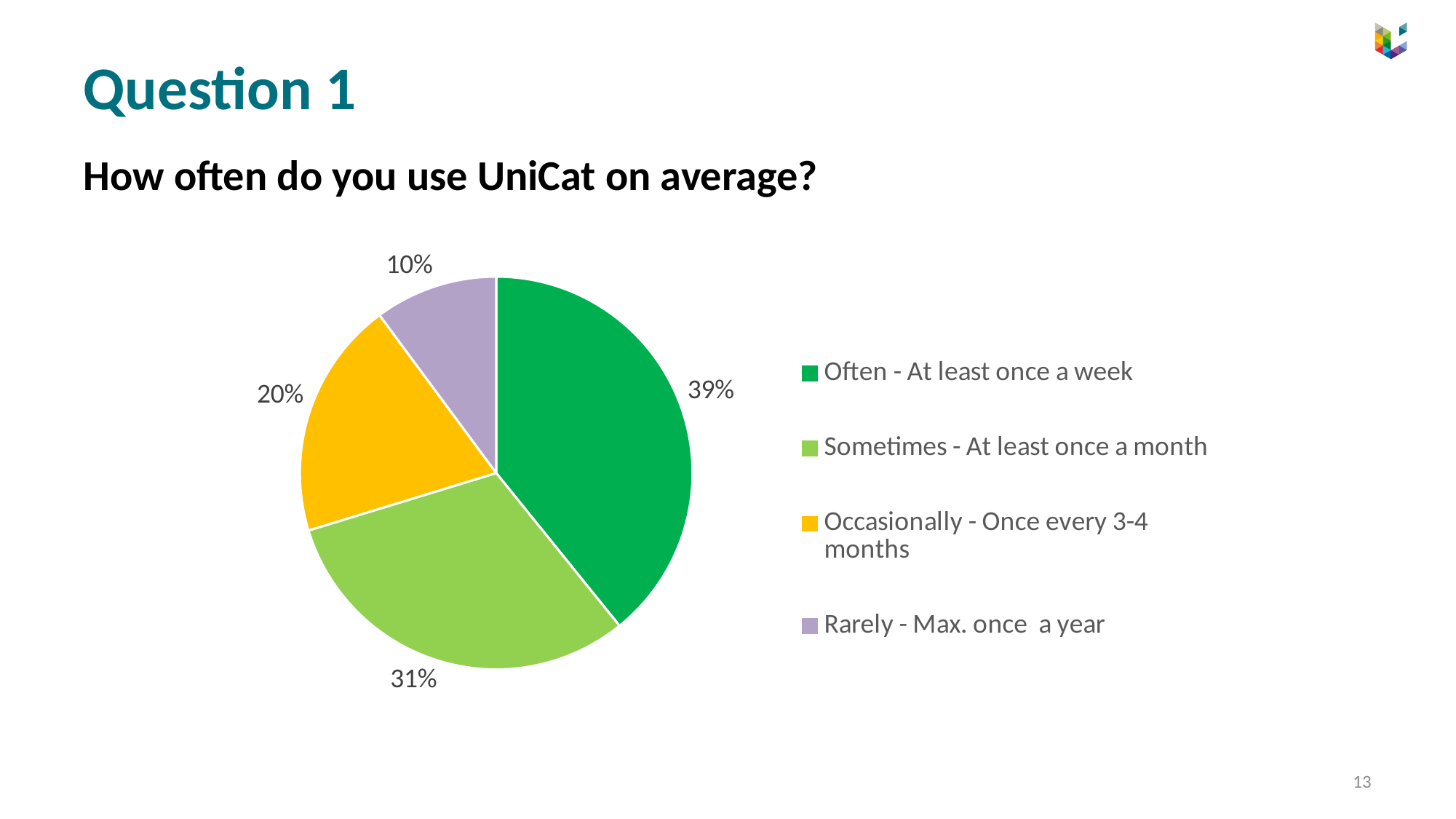
Which usage frequency category has the smallest share of the pie? Rarely - Max. once a year What share of respondents use UniCat rarely (max. once a year)? 10% Which slice is larger: 'Sometimes - At least once a month' or 'Occasionally - Once every 3-4 months'? Sometimes - At least once a month How many categories does the pie chart have? 4 What colour is the slice for 'Rarely - Max. once a year'? purple What share of respondents use UniCat often (at least once a week)? 39% What kind of chart is shown on the slide? pie chart What is the difference in percentage points between the 'Often' and 'Sometimes' slices? 8% What share of respondents use UniCat occasionally (once every 3-4 months)? 20% What is the difference in percentage points between the 'Occasionally' and 'Rarely' slices? 10% Which usage frequency category has the largest share of the pie? Often - At least once a week